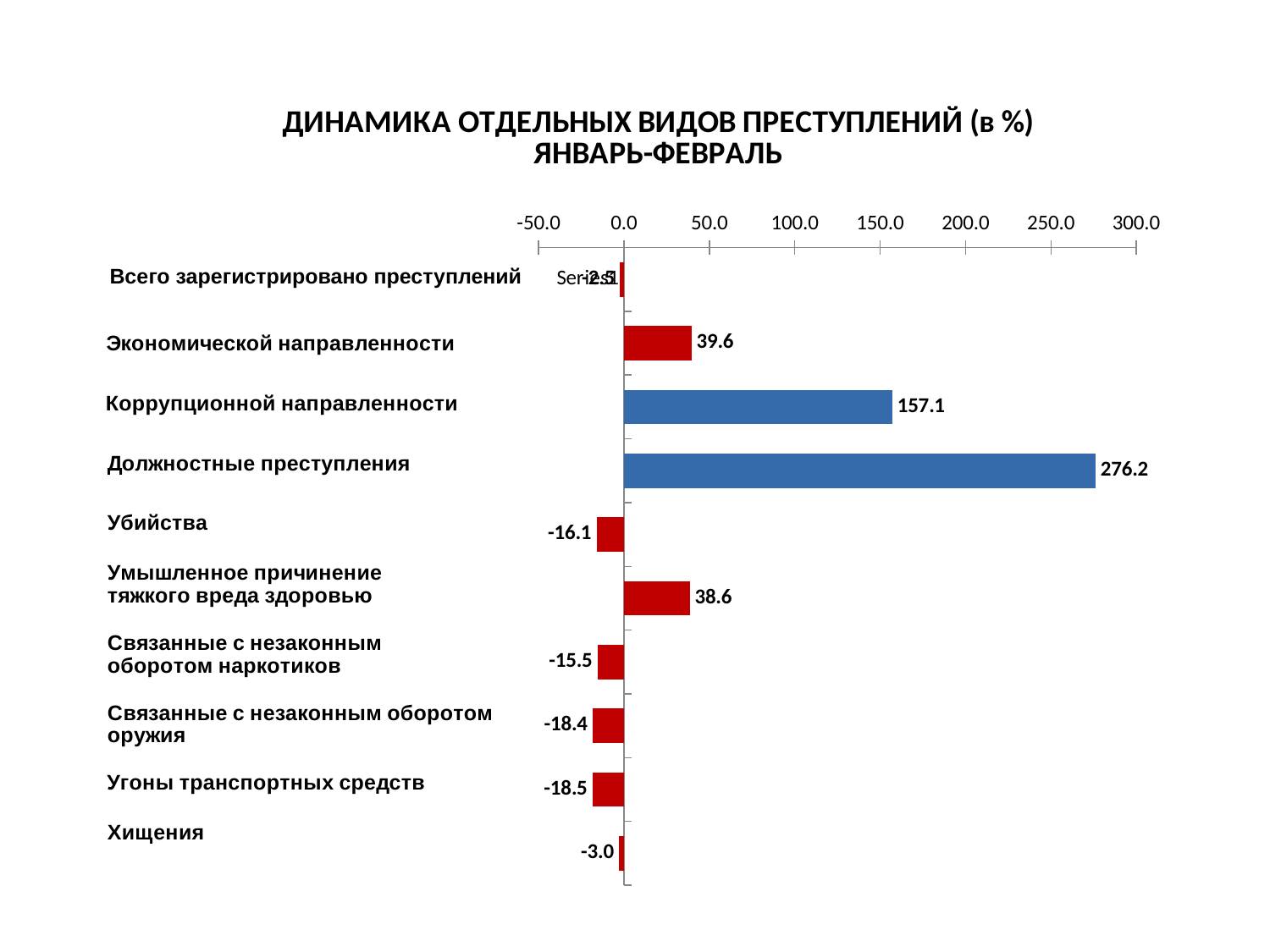
What is the difference between the values for Должностные преступления and Коррупционной направленности? 119.1 Is the value for Коррупционной направленности greater or less than 150.0? greater What is the value for Убийства? -16.1 Which two categories are drawn with blue bars? Коррупционной направленности and Должностные преступления Which is larger: the value for Экономической направленности or the value for Убийства? Экономической направленности Which category has the highest value? Должностные преступления How many categories are shown in the chart? 10 What is the value for Хищения? -3.0 What kind of chart is shown on the slide? bar chart What is the value for Должностные преступления? 276.2 What is the value for Угоны транспортных средств? -18.5 What is the value for Коррупционной направленности? 157.1